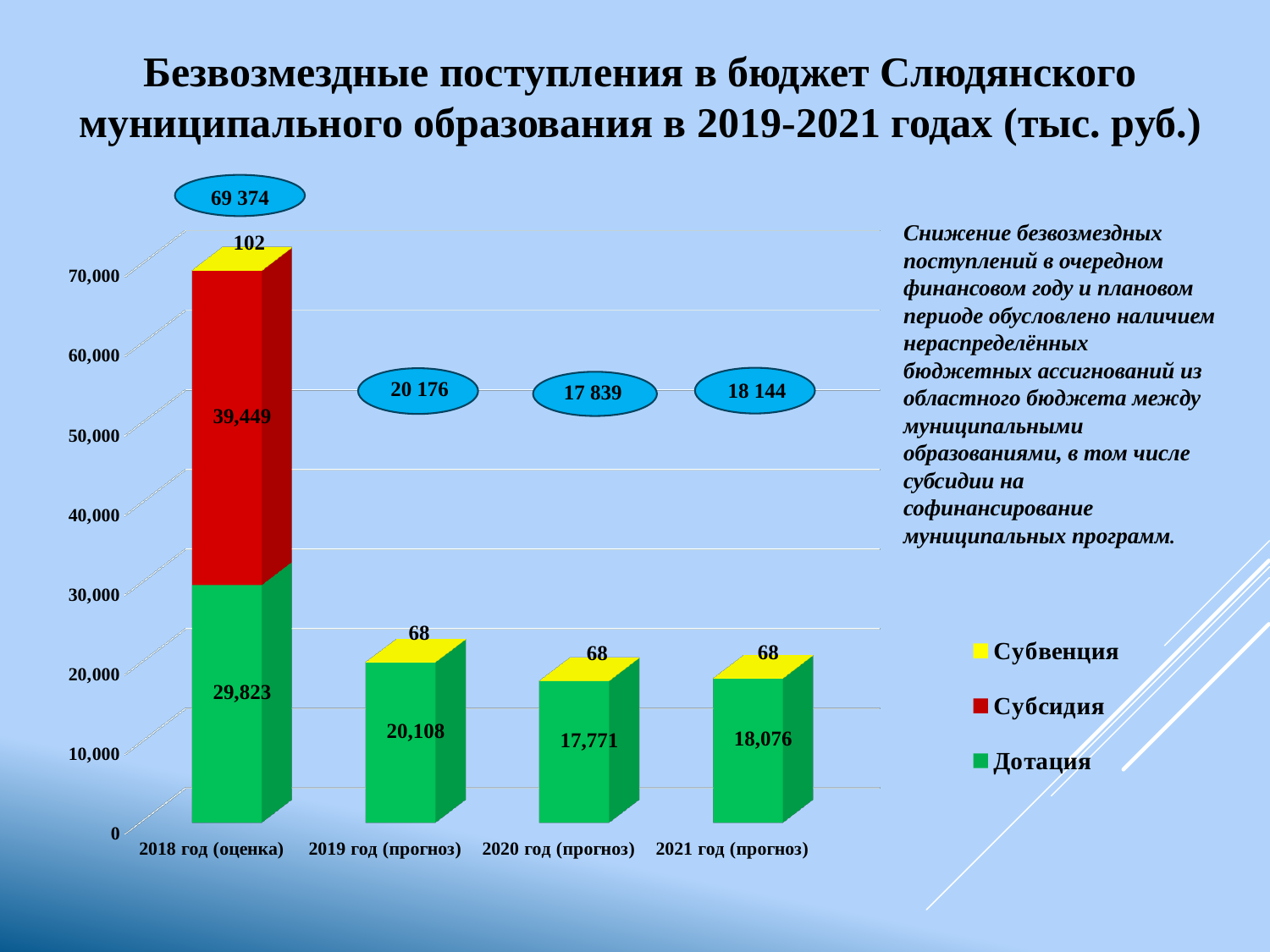
Is the Дотация value larger for 2019 год (прогноз) or for 2021 год (прогноз)? 2019 год (прогноз) What is the total shown above the bar for 2018 год (оценка)? 69 374 What kind of chart is shown on the slide? Stacked bar chart What is the Дотация value for 2020 год (прогноз)? 17,771 What is the Субсидия value for 2018 год (оценка)? 39,449 What is the Субвенция value for 2019 год (прогноз)? 68 Which year has the highest Дотация value? 2018 год (оценка) What is the difference between the Дотация values for 2021 год (прогноз) and 2020 год (прогноз)? 305 How many categories (years) are shown on the x axis? 4 What is the Дотация value for 2018 год (оценка)? 29,823 How many series does the legend list? 3 Which year has the lowest Дотация value? 2020 год (прогноз)